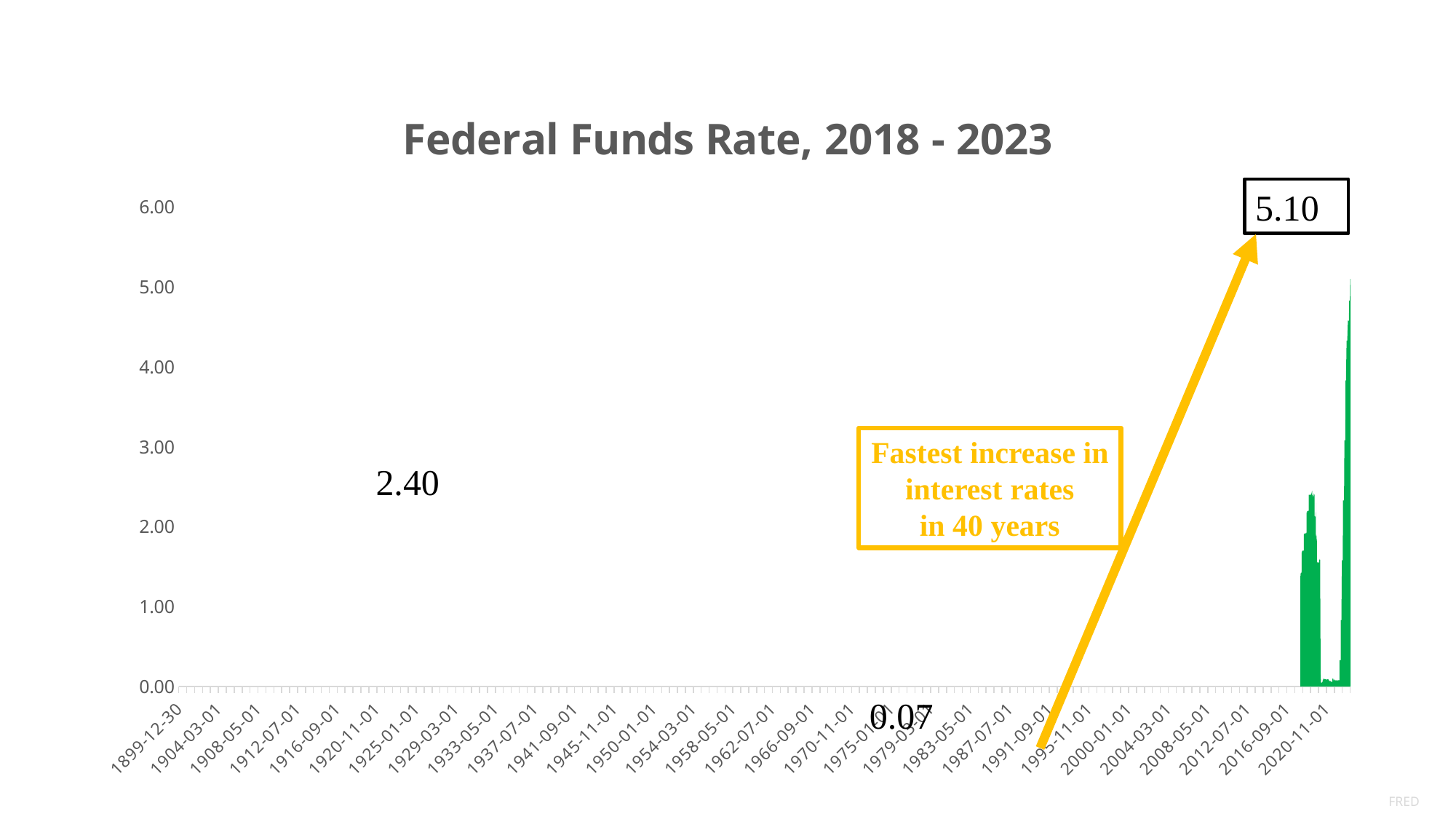
What is the difference between the annotated high of 5.10 and the annotated low of 0.07? 5.03 What is the title of the chart? Federal Funds Rate, 2018 - 2023 What is the lowest value annotated on the chart? 0.07 What value is annotated for the earlier, smaller peak of the Federal Funds Rate? 2.40 Does the Federal Funds Rate rise or fall at the far right end of the chart? rise What is the highest value shown on the y axis? 6.00 Is the final peak of the Federal Funds Rate greater or less than 4.00? greater Which annotated value is larger, 5.10 or 2.40? 5.10 What does the yellow callout box on the chart say? Fastest increase in interest rates in 40 years Is the lowest point of the Federal Funds Rate greater or less than 1.00? less What is the difference between the annotated peak value 5.10 and the earlier peak value 2.40? 2.70 What is the highest value annotated on the chart? 5.10